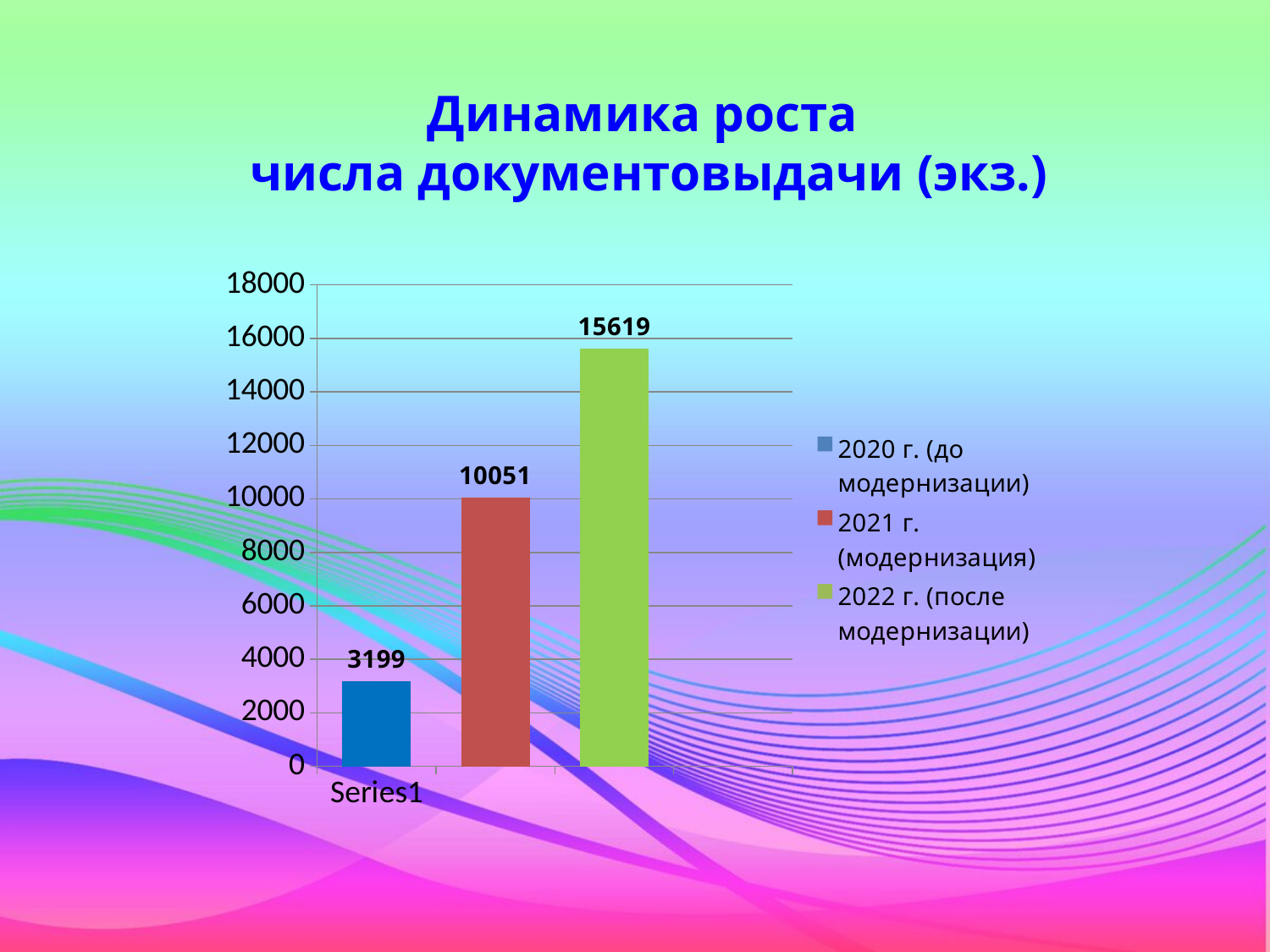
Is the value for 2021 г. (модернизация) greater or less than 8000? greater Do the values rise or fall from 2020 to 2022? rise What kind of chart is shown on the slide? bar chart Which series has the lowest value? 2020 г. (до модернизации) What is the difference between the values for 2021 г. (модернизация) and 2020 г. (до модернизации)? 6852 What is the value for 2021 г. (модернизация)? 10051 What is the value for 2020 г. (до модернизации)? 3199 What is the difference between the values for 2022 г. (после модернизации) and 2020 г. (до модернизации)? 12420 What is the value for 2022 г. (после модернизации)? 15619 How many series does the legend list? 3 Which series has the highest value? 2022 г. (после модернизации) Which is larger, the value for 2021 г. (модернизация) or the value for 2022 г. (после модернизации)? 2022 г. (после модернизации)